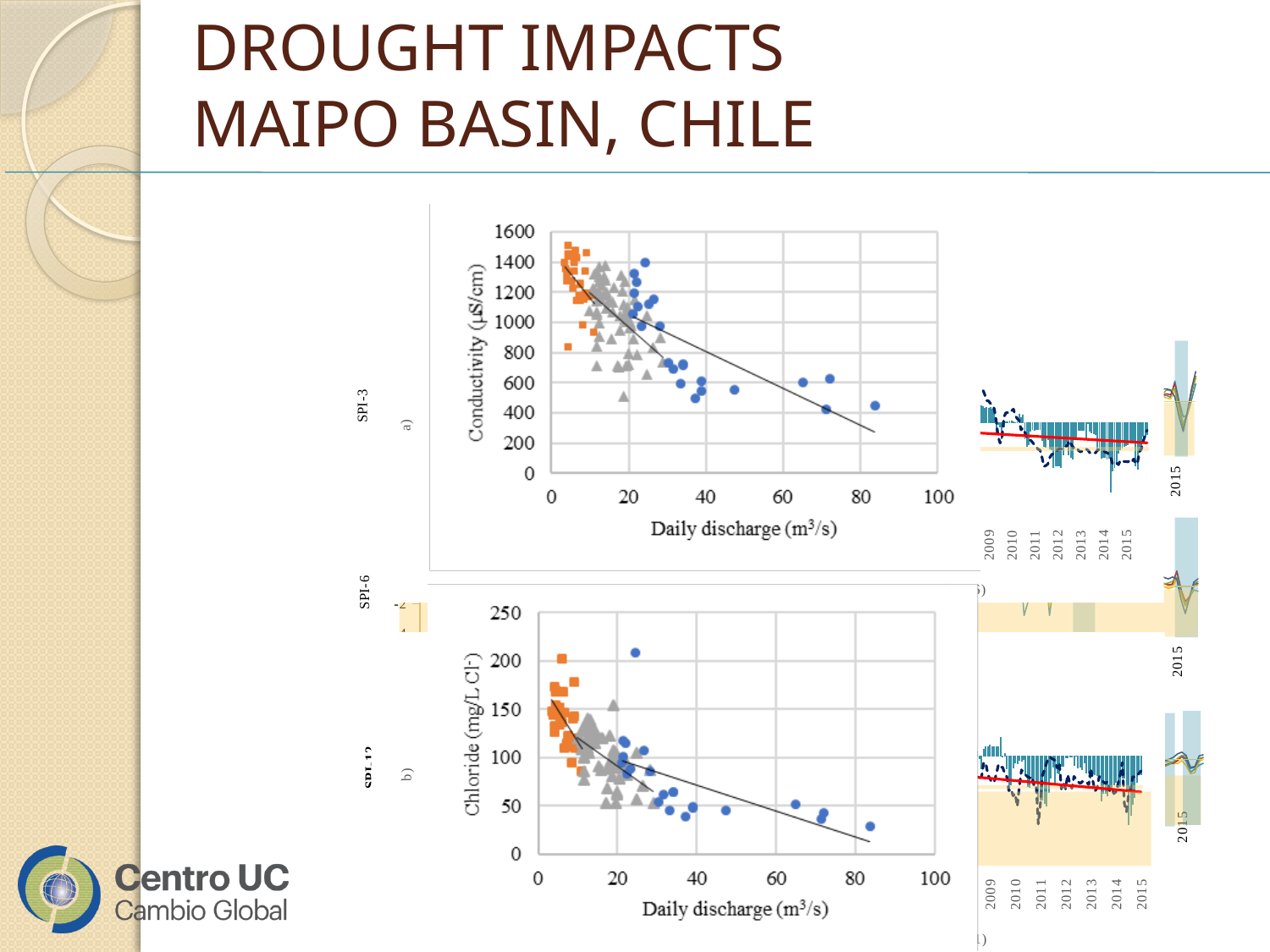
What is the y-axis label of the top chart? Conductivity (μS/cm) In the bottom chart, does chloride generally rise or fall as daily discharge increases? fall In the top chart, is the conductivity of the point with the highest daily discharge (around 83 m³/s) greater or less than 600? less In the top chart, is the highest conductivity value plotted greater or less than 1400? greater In the bottom chart, is the highest chloride value plotted greater or less than 150? greater What is the x-axis label of the bottom chart? Daily discharge (m³/s) What kind of chart is the bottom chart (Chloride vs Daily discharge)? scatter chart In the top chart, does conductivity generally rise or fall as daily discharge increases? fall What kind of chart is the top chart (Conductivity vs Daily discharge)? scatter chart